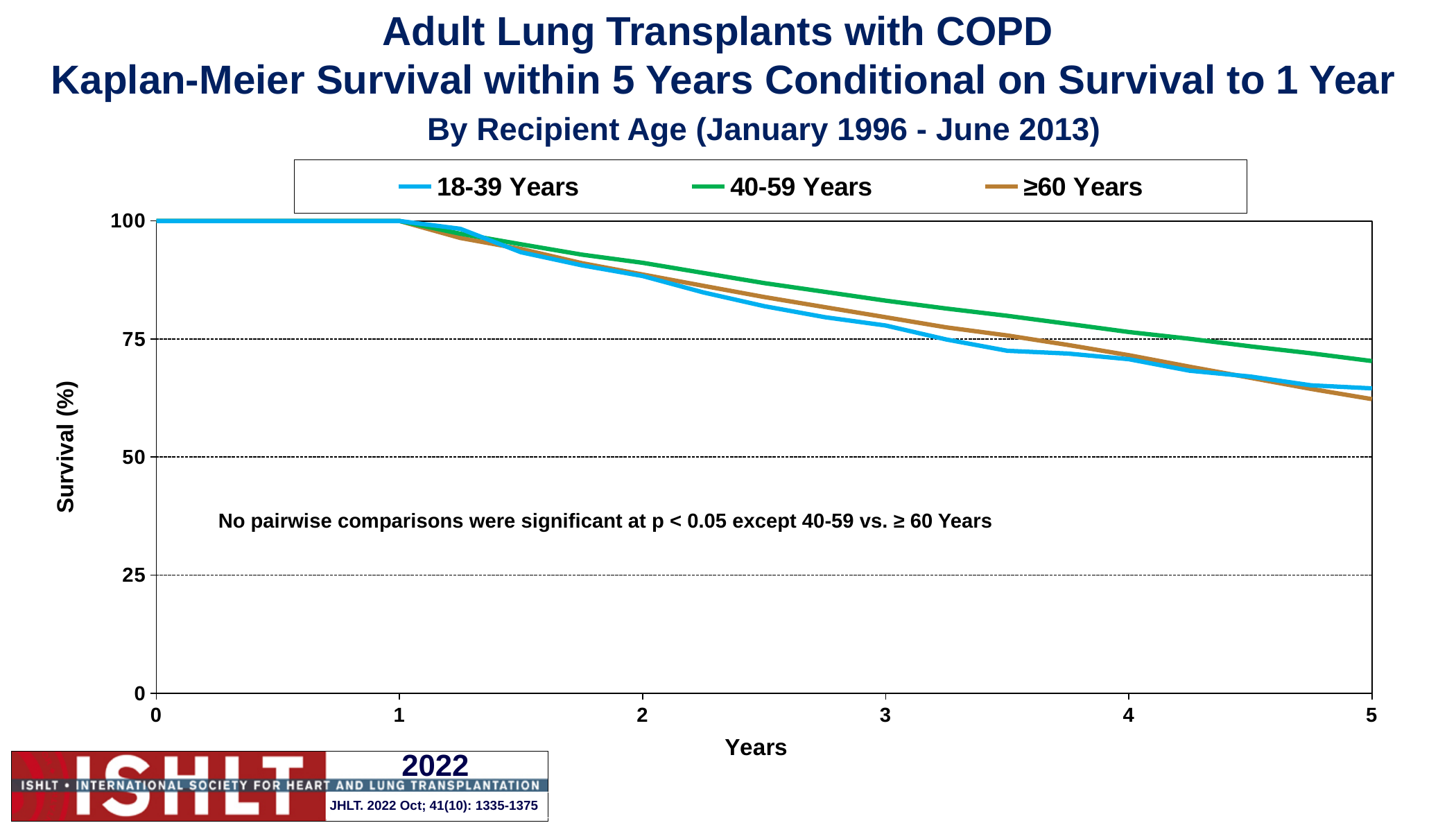
What is the label of the y-axis? Survival (%) What is the survival (%) for all three age groups at year 1? 100 Which age group has the highest survival at 5 years? 40-59 Years At year 5, which has higher survival: 40-59 Years or ≥60 Years? 40-59 Years Is the survival for ≥60 Years at year 5 greater or less than 50? greater Which colour represents the 18-39 Years series in the legend? Blue How many series does the legend list? 3 Is the survival for 40-59 Years at year 5 greater or less than 75? less What kind of chart is shown on the slide? Line chart Do the survival curves rise or fall as years increase after year 1? Fall Is the survival for 18-39 Years at year 3 greater or less than 75? greater